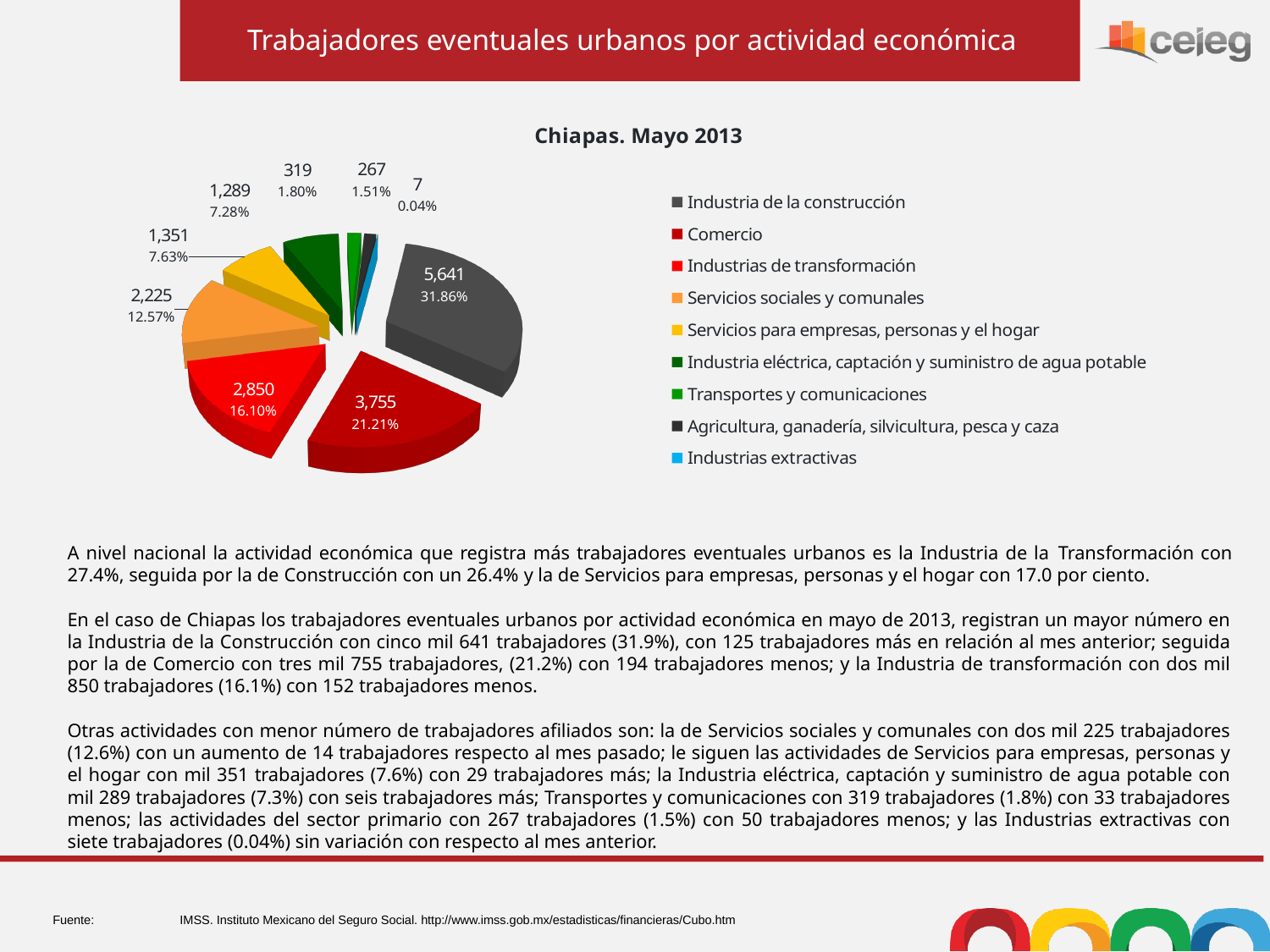
What is the value shown for Industrias de transformación? 2,850 Which is larger, the value for Servicios para empresas, personas y el hogar or the value for Industria eléctrica, captación y suministro de agua potable? Servicios para empresas, personas y el hogar What type of chart is shown on the slide? pie chart How many categories does the legend of the pie chart list? 9 What is the subtitle shown above the pie chart? Chiapas. Mayo 2013 What percentage share does Servicios sociales y comunales have? 12.57% What percentage share does Comercio have in the pie chart? 21.21% What is the value shown for Industria de la construcción? 5,641 What is the difference between the values for Industria de la construcción and Comercio? 1,886 Which category has the smallest slice of the pie chart? Industrias extractivas Which category has the largest slice of the pie chart? Industria de la construcción What is the value shown for Transportes y comunicaciones? 319